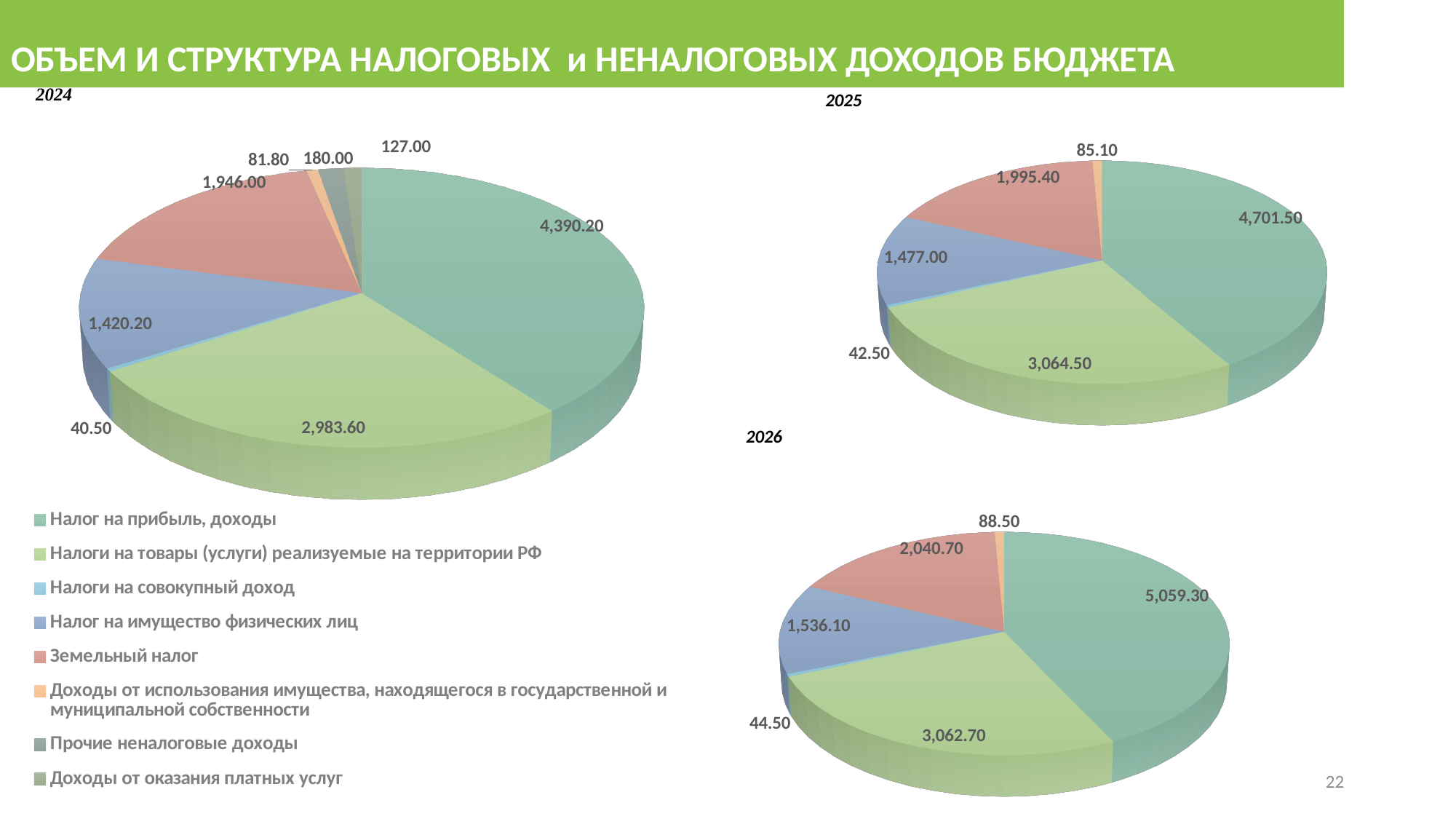
In the 2024 pie chart, what is the value for Налог на прибыль, доходы? 4,390.20 In the 2025 pie chart, what is the value for Земельный налог? 1,995.40 How many data labels are shown on the 2025 pie chart? 6 How many entries does the legend on the slide list? 8 In the 2024 pie chart, which is larger: Налоги на товары (услуги) реализуемые на территории РФ or Земельный налог? Налоги на товары (услуги) реализуемые на территории РФ In the 2024 pie chart, what is the value for Прочие неналоговые доходы? 180.00 In the 2025 pie chart, which category has the smallest value? Налоги на совокупный доход What type of chart is used for the 2024, 2025 and 2026 data? Pie chart In the 2024 pie chart, what is the difference between Земельный налог and Налог на имущество физических лиц? 525.80 In the 2026 pie chart, what is the value for Налог на имущество физических лиц? 1,536.10 In the 2026 pie chart, which category has the largest slice? Налог на прибыль, доходы What is the difference between the value for Налог на прибыль, доходы in the 2026 chart and in the 2025 chart? 357.80